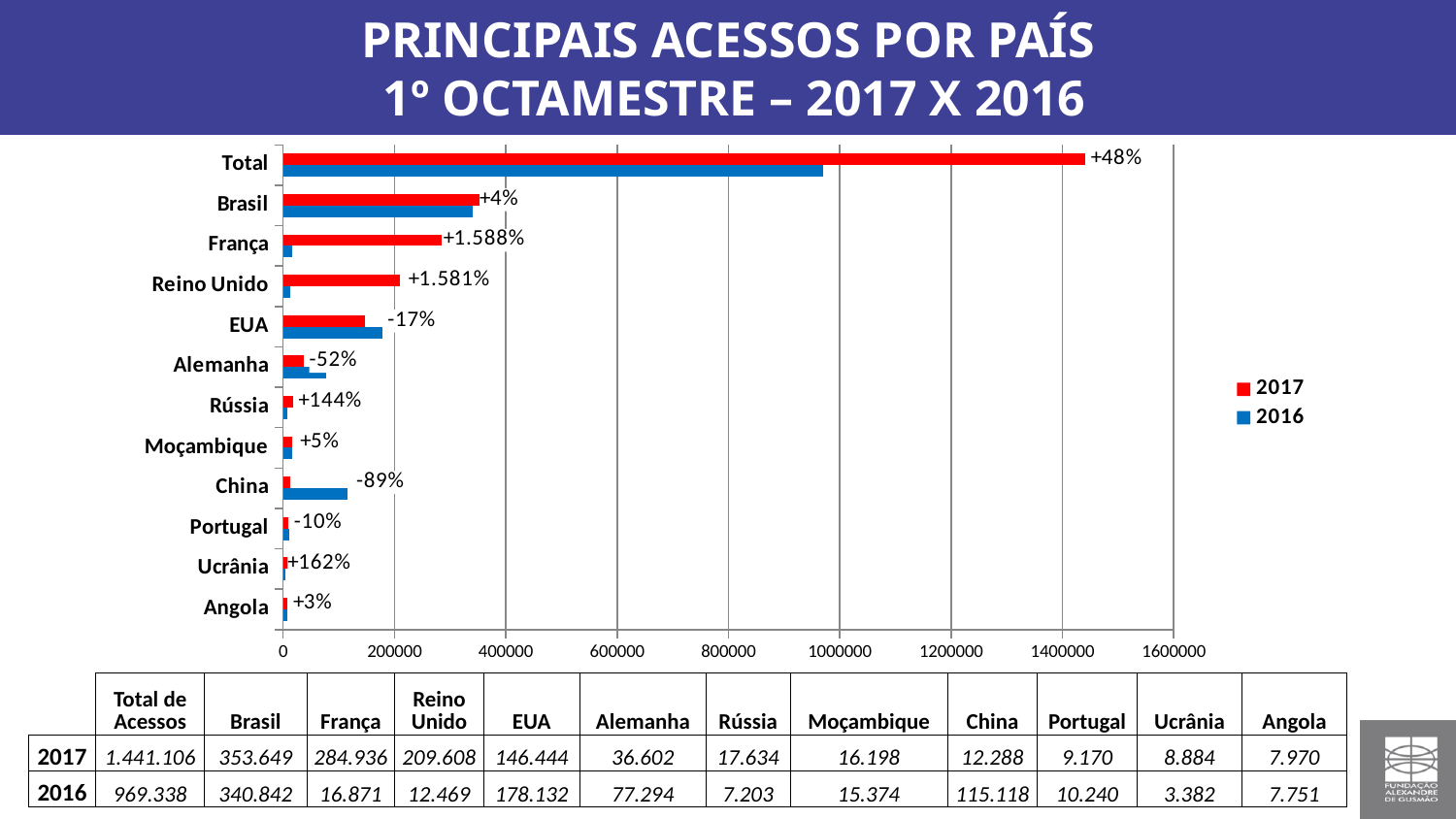
Which colour represents the 2017 series in the legend? red What kind of chart is shown on the slide? bar chart How many categories are plotted on the chart's vertical axis? 12 What is the 2016 value for China? 115.118 For EUA, which is larger: the 2017 value or the 2016 value? 2016 How many series does the chart legend list? 2 What is the difference between the 2017 and 2016 values for Brasil? 12.807 What percentage change label is shown for China? -89% Is the 2016 value for Total greater or less than 800000? greater Excluding the Total row, which country has the highest 2017 value? Brasil What percentage change label is shown next to the bars for França? +1.588% What is the 2017 value for EUA? 146.444